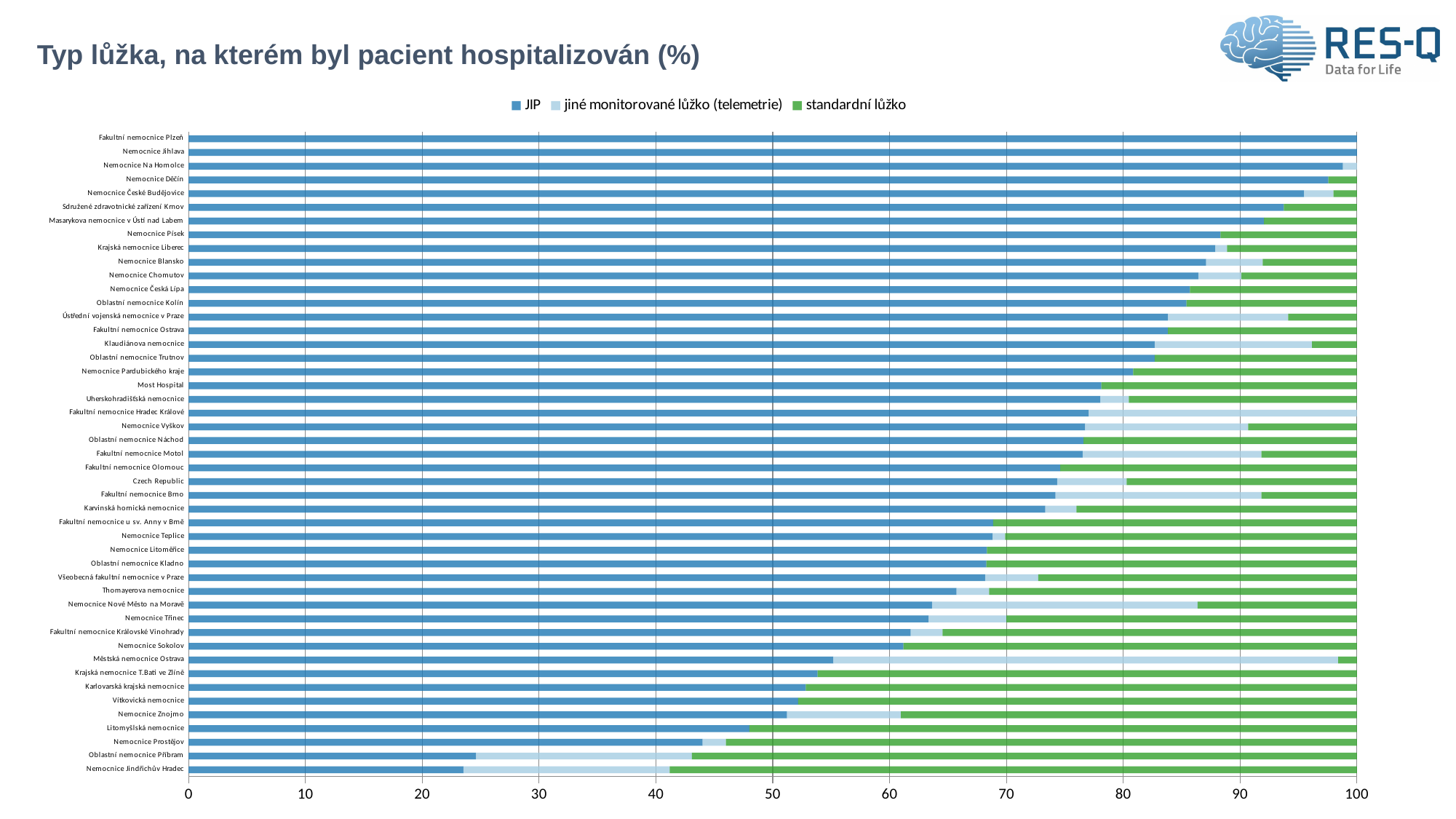
What kind of chart is shown on the slide? Stacked bar chart What is the JIP value for Nemocnice Jihlava? 100 How many hospitals (categories) are plotted on the chart? 47 What is the title of the chart? Typ lůžka, na kterém byl pacient hospitalizován (%) Which has the larger jiné monitorované lůžko (telemetrie) value, Městská nemocnice Ostrava or Nemocnice Jindřichův Hradec? Městská nemocnice Ostrava Is the JIP value for Nemocnice Jindřichův Hradec greater or less than 30? less Is the JIP value for Czech Republic greater or less than 70? greater What is the JIP value for Fakultní nemocnice Plzeň? 100 How many series does the legend list? 3 Is the JIP value for Městská nemocnice Ostrava greater or less than 50? greater What are the three series named in the legend? JIP, jiné monitorované lůžko (telemetrie), standardní lůžko Which has the larger JIP value, Nemocnice Sokolov or Nemocnice Znojmo? Nemocnice Sokolov